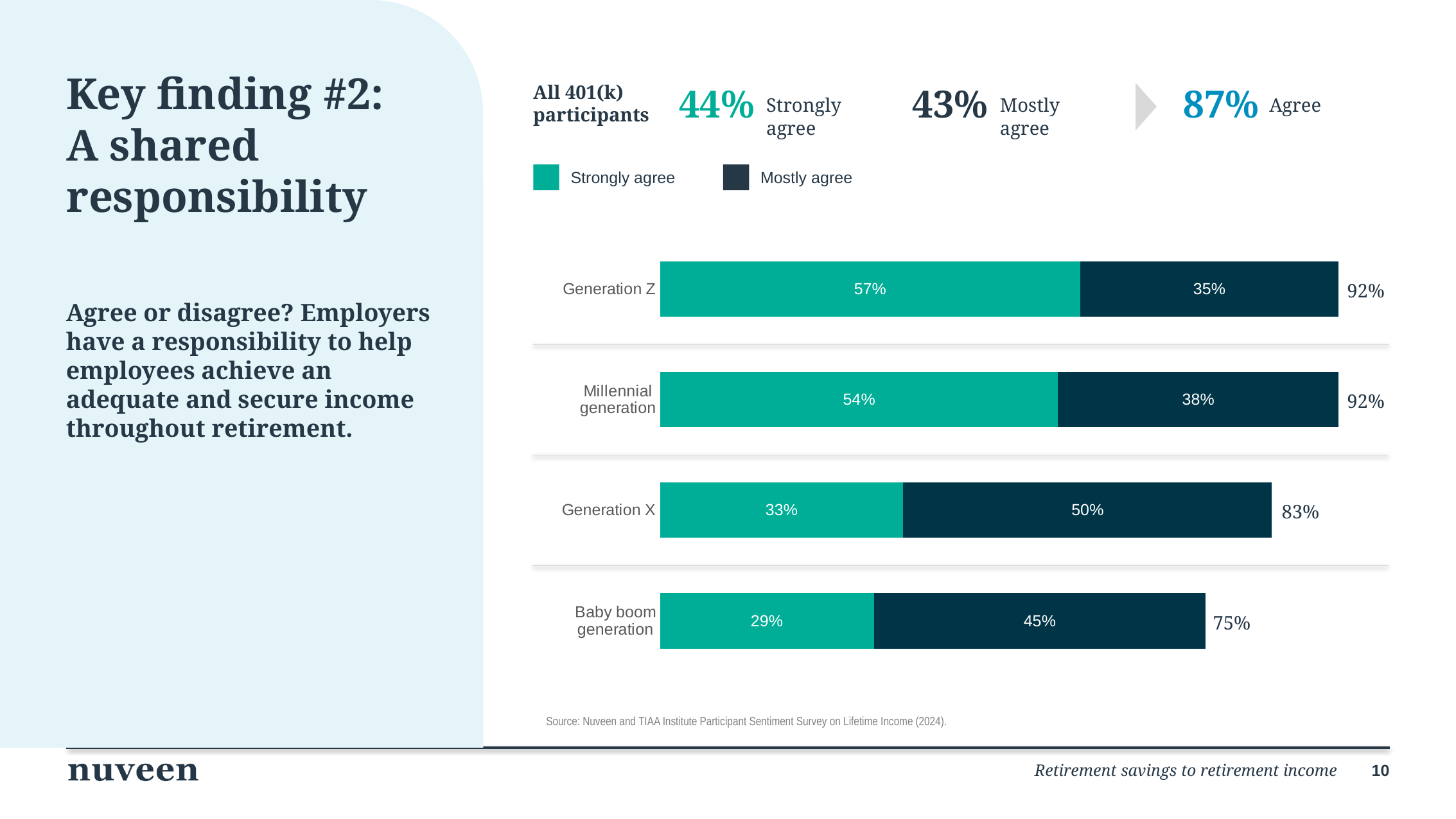
What kind of chart is shown on the slide? Stacked bar chart What is the total agree percentage for Generation X? 83% How many series does the legend list? 2 How many generations are shown in the chart? 4 Which is larger: the 'Strongly agree' percentage for the Millennial generation or for Generation X? Millennial generation What is the difference between the 'Mostly agree' percentages for Generation X and Generation Z? 15% Which colour represents 'Strongly agree' in the legend? Green What percentage of all 401(k) participants agree in total? 87% Which generation has the highest 'Strongly agree' percentage? Generation Z Which generation has the lowest total agree percentage? Baby boom generation What percentage of Generation Z strongly agree? 57% What percentage of the Baby boom generation mostly agree? 45%